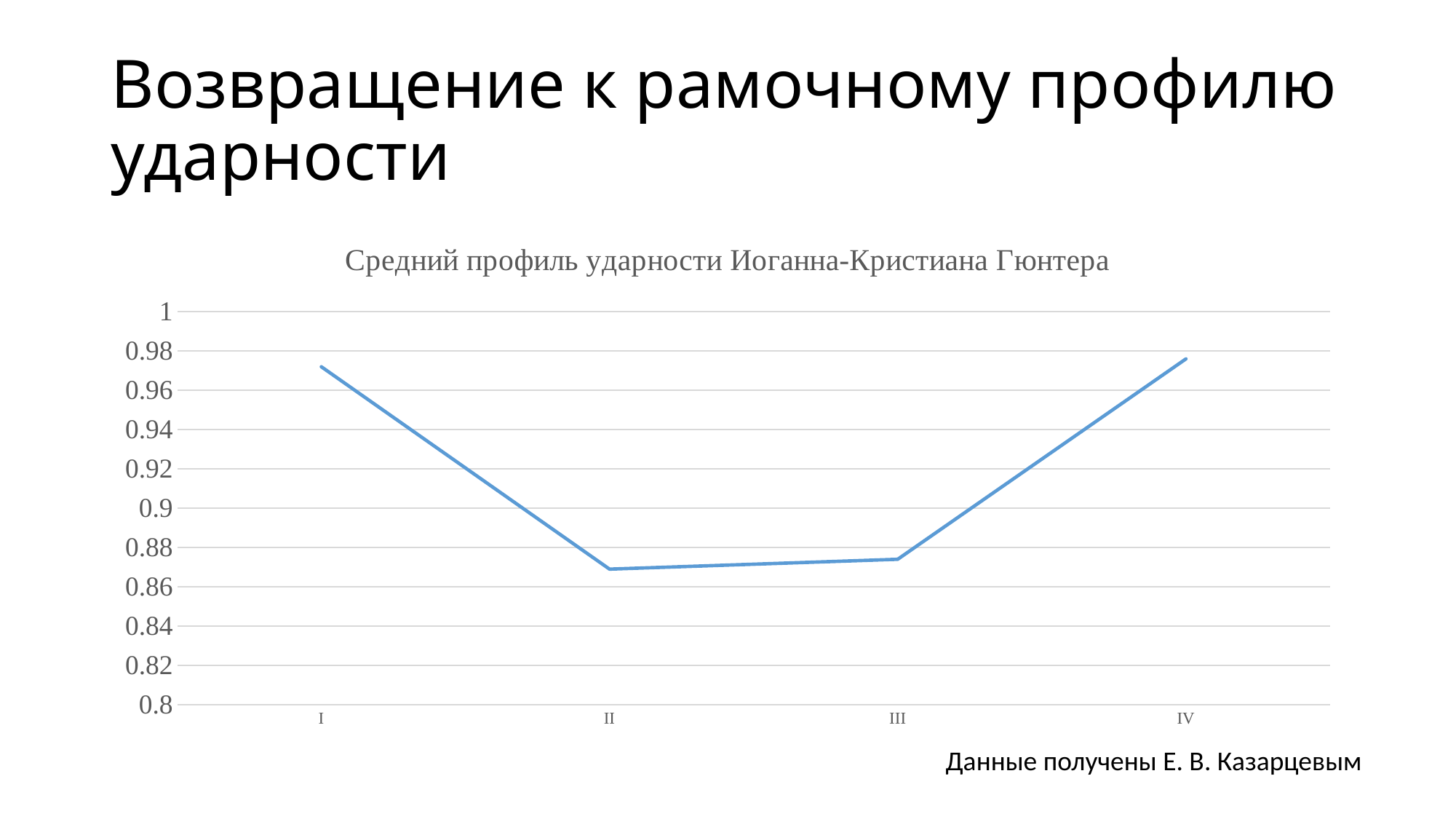
Does the line rise or fall from III to IV? rises Is the value for III greater or less than 0.9? less How many points are plotted along the x axis of the chart? 4 Does the line rise or fall from I to II? falls Which has the larger value, III or IV? IV Which has the larger value, I or II? I Is the value for IV greater or less than 0.96? greater What kind of chart is shown on the slide? line chart What is the title of the chart? Средний профиль ударности Иоганна-Кристиана Гюнтера What is the highest value shown on the vertical axis of the chart? 1 Is the value for I greater or less than 0.96? greater